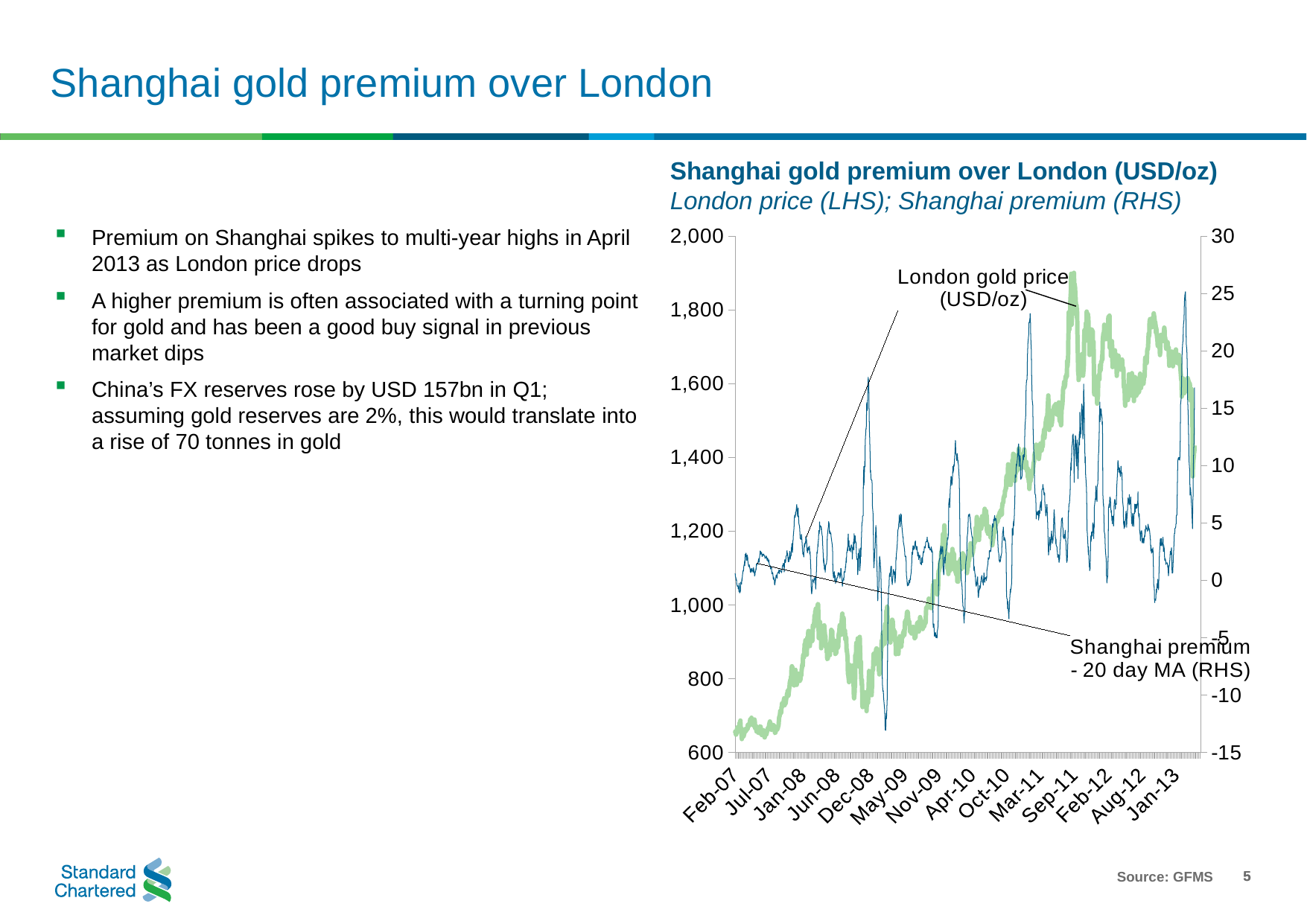
Is the peak of the London gold price around Sep-11 greater or less than 1,800? greater What is the title of the chart? Shanghai gold premium over London (USD/oz) What is the highest value shown on the left-hand axis? 2,000 How many date labels are shown on the x axis? 14 Is the London gold price at Feb-07 greater or less than 800? less Is the London gold price at Jan-13 greater or less than 1,400? greater Which series is plotted on the right-hand axis (RHS)? Shanghai premium - 20 day MA What kind of chart is shown on the slide? Line chart How many data series are plotted on the chart? 2 Does the London gold price generally rise or fall between Feb-07 and Sep-11? rise